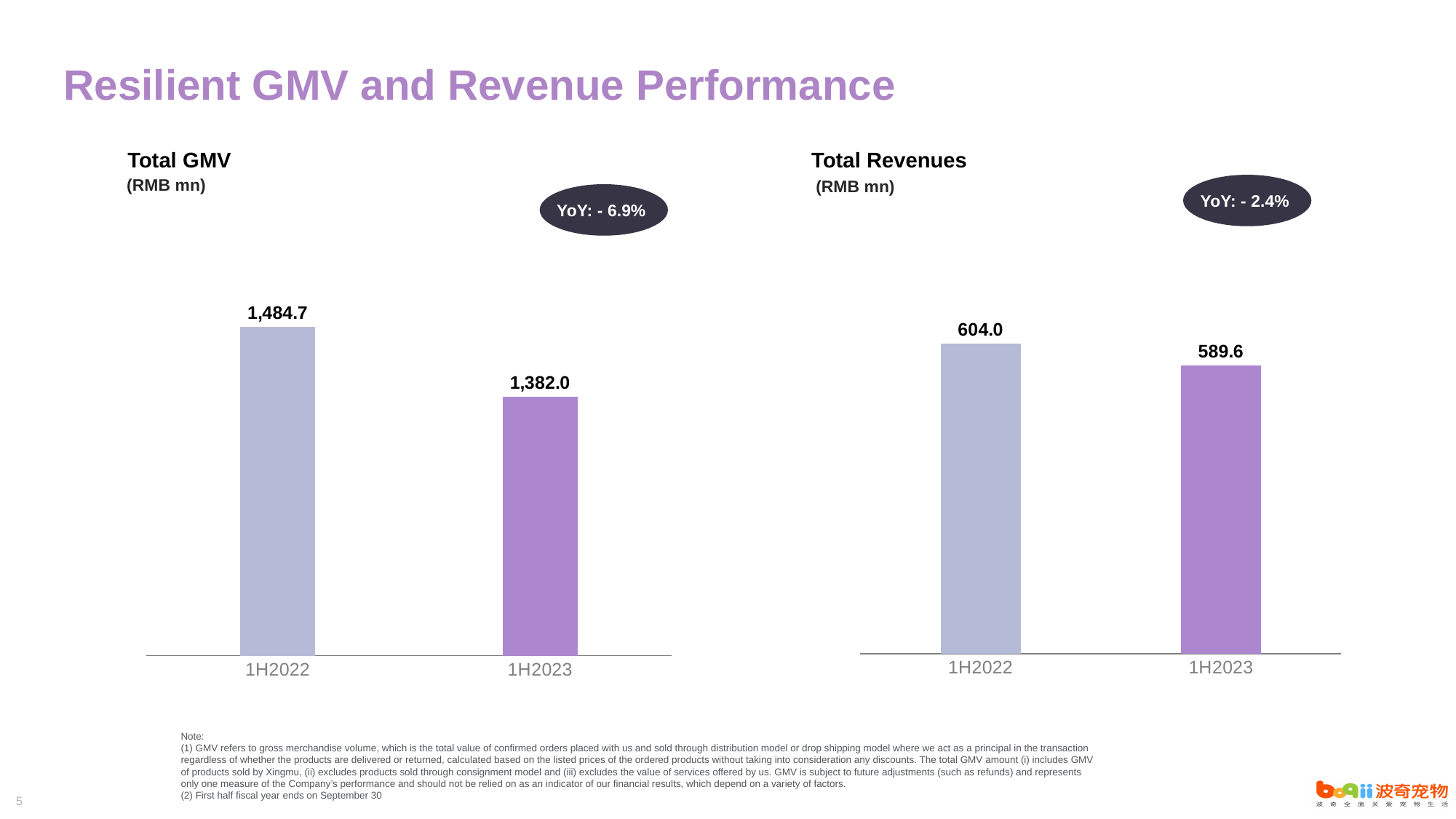
In the Total GMV chart, which period has the higher value? 1H2022 What YoY change is shown for the Total GMV chart? - 6.9% In the Total GMV chart, what is the value for 1H2022? 1,484.7 In the Total GMV chart, what is the difference between the 1H2022 and 1H2023 values? 102.7 How many bars are plotted in the Total GMV chart? 2 In the Total Revenues chart, is the value for 1H2022 larger or smaller than the value for 1H2023? larger In the Total Revenues chart, what is the value for 1H2022? 604.0 In the Total GMV chart, what is the value for 1H2023? 1,382.0 In the Total Revenues chart, what is the value for 1H2023? 589.6 In the Total Revenues chart, which period has the lower value? 1H2023 What kind of chart is the Total Revenues chart? bar chart In the Total Revenues chart, what is the difference between the 1H2022 and 1H2023 values? 14.4